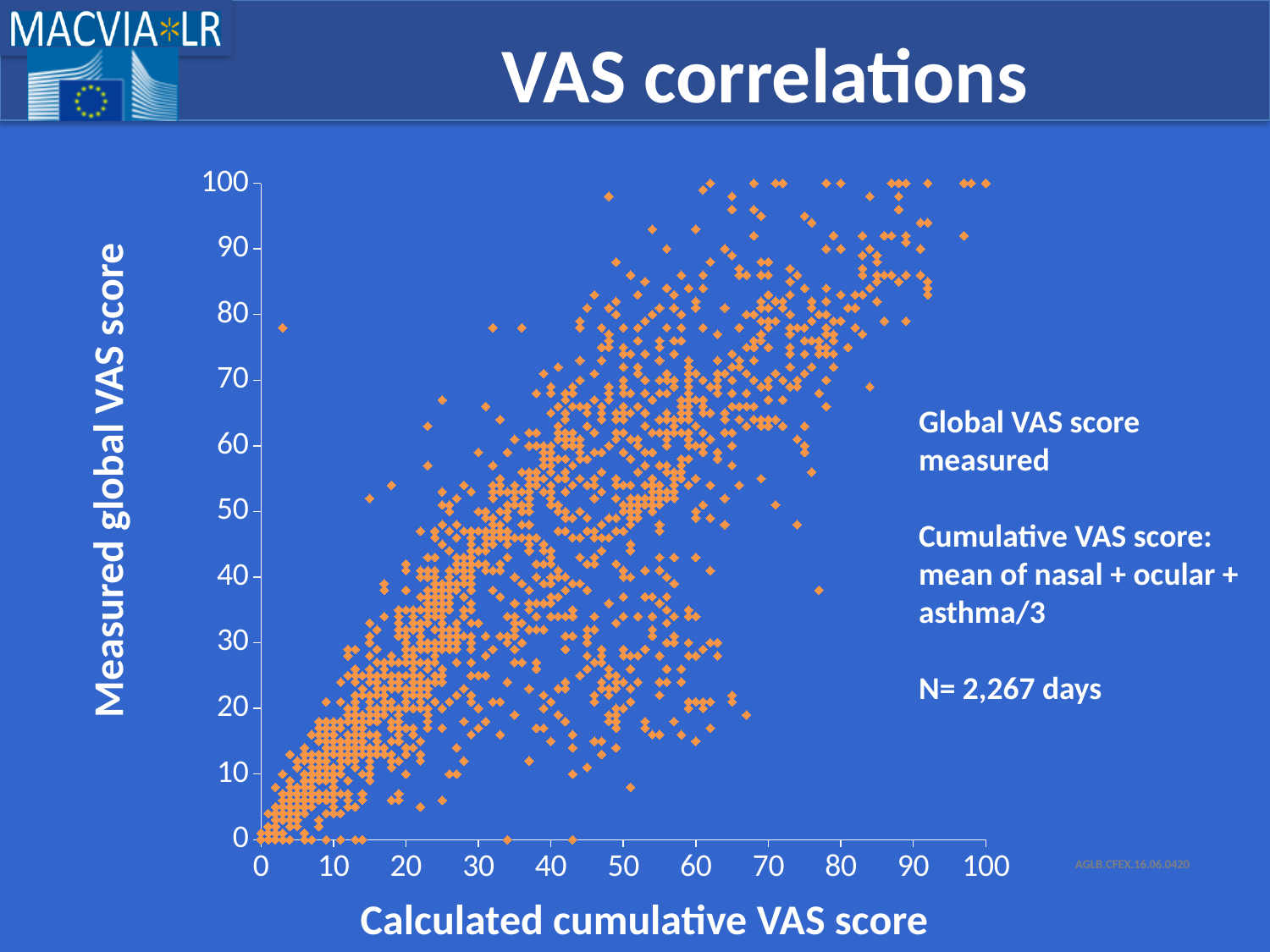
What is the title of the y axis of the chart? Measured global VAS score What kind of chart is shown on the slide? scatter chart As the calculated cumulative VAS score increases along the x axis, do the measured global VAS scores generally rise or fall? rise What is the title of the x axis of the chart? Calculated cumulative VAS score